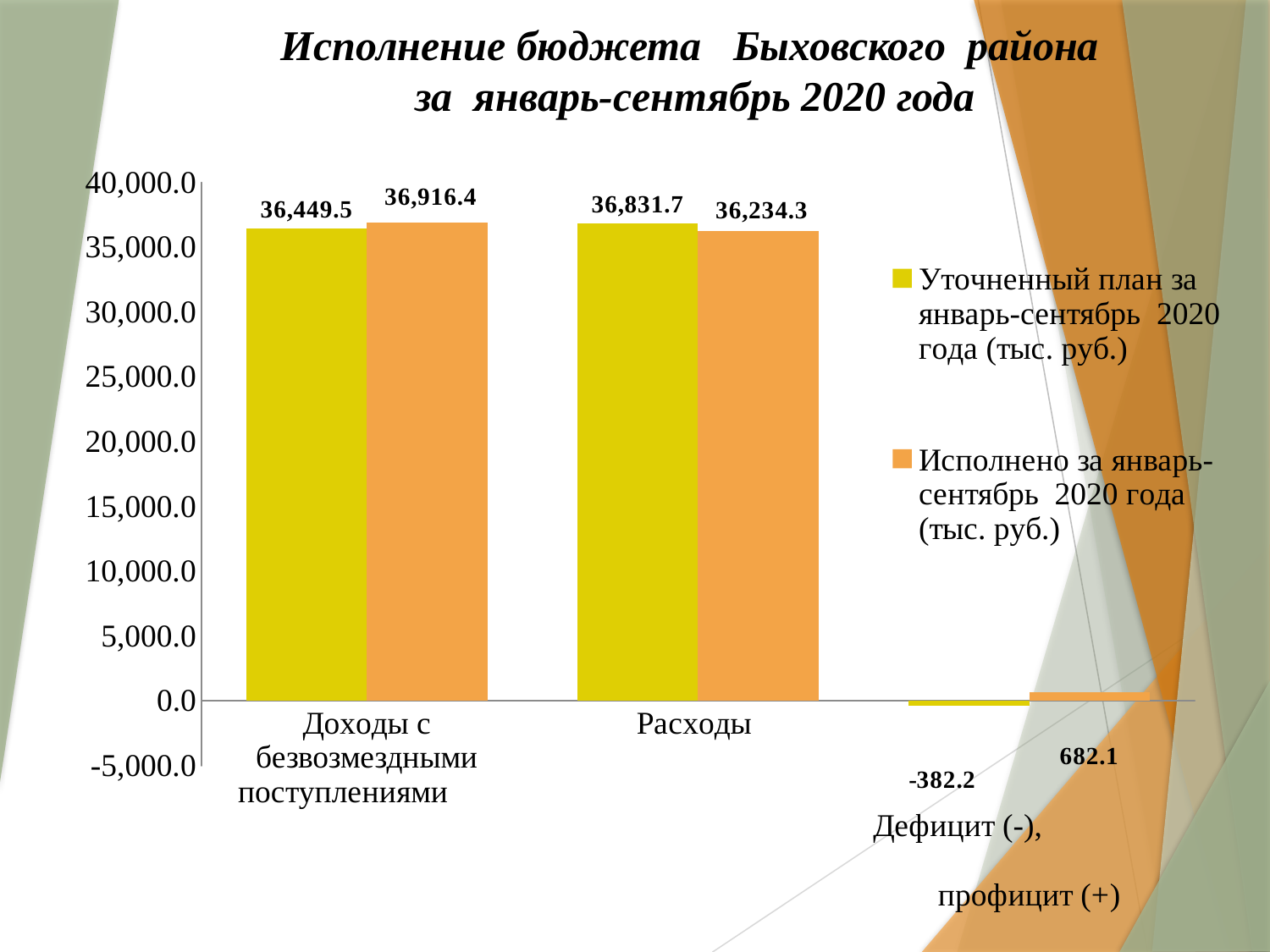
What type of chart is shown on the slide? bar chart What is the title of the chart? Исполнение бюджета Быховского района за январь-сентябрь 2020 года What is the value of 'Уточненный план за январь-сентябрь 2020 года (тыс. руб.)' for 'Расходы'? 36,831.7 How many categories are shown on the x axis? 3 What is the difference between the executed value and the planned value for 'Доходы с безвозмездными поступлениями'? 466.9 How many series does the legend list? 2 What is the difference between the executed value and the planned value for 'Расходы'? 597.4 What is the value of 'Уточненный план за январь-сентябрь 2020 года (тыс. руб.)' for 'Дефицит (-), профицит (+)'? -382.2 Which series has the larger value for 'Расходы'? Уточненный план за январь-сентябрь 2020 года (тыс. руб.) What is the value of 'Уточненный план за январь-сентябрь 2020 года (тыс. руб.)' for 'Доходы с безвозмездными поступлениями'? 36,449.5 What is the value of 'Исполнено за январь-сентябрь 2020 года (тыс. руб.)' for 'Дефицит (-), профицит (+)'? 682.1 What is the value of 'Исполнено за январь-сентябрь 2020 года (тыс. руб.)' for 'Доходы с безвозмездными поступлениями'? 36,916.4